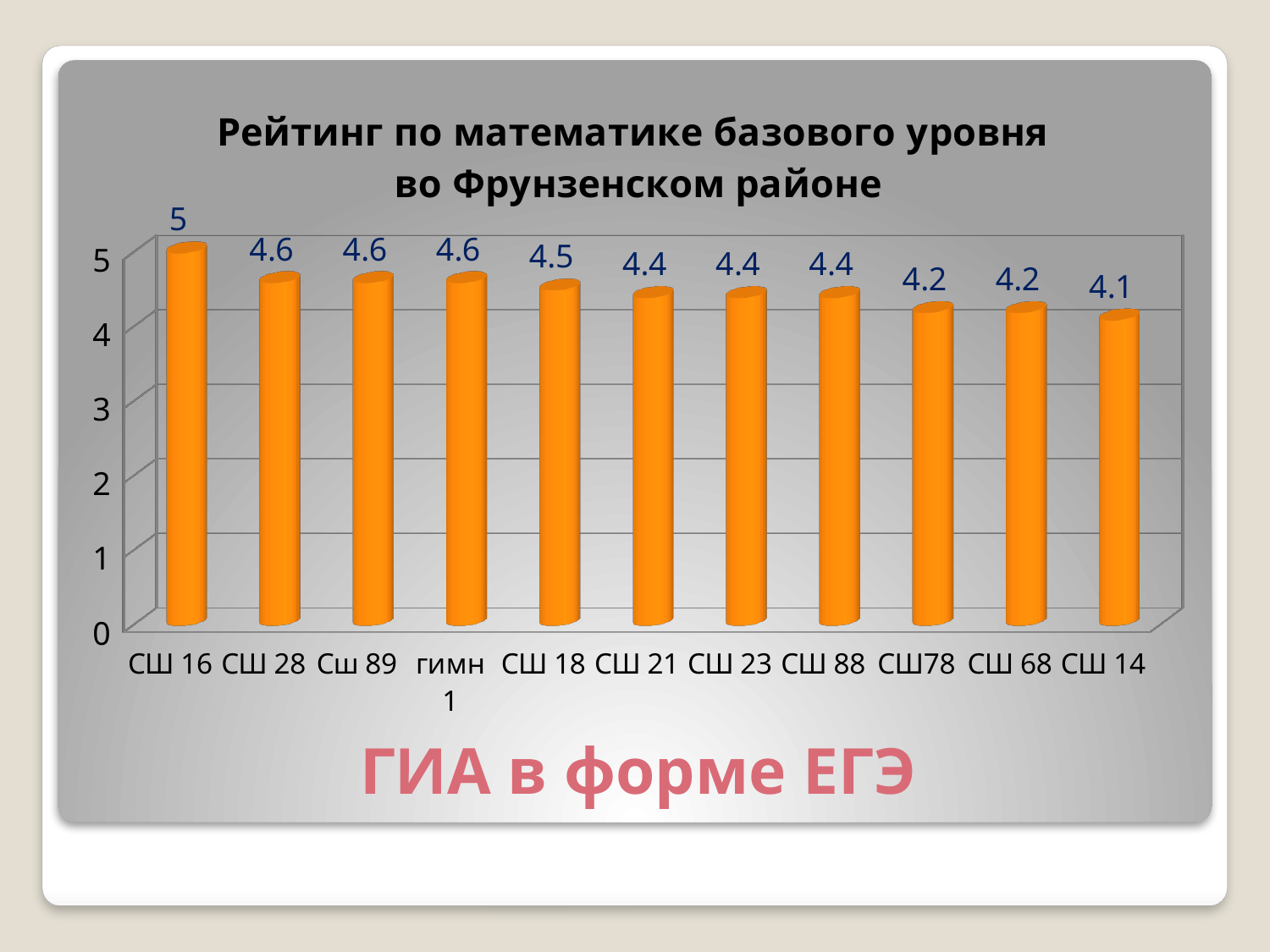
What is the value for СШ 14? 4.1 Is the value for СШ 21 greater or less than 4? greater What is the value for СШ 16? 5 What is the value for СШ 18? 4.5 Which category has the highest value? СШ 16 Which is larger, the value for СШ 28 or the value for СШ 68? СШ 28 Which category has the lowest value? СШ 14 How many categories are shown on the chart? 11 Do the values rise or fall from left to right along the x axis? fall What is the difference between the values for СШ 16 and СШ 14? 0.9 What is the value for гимн 1? 4.6 What kind of chart is shown on the slide? bar chart